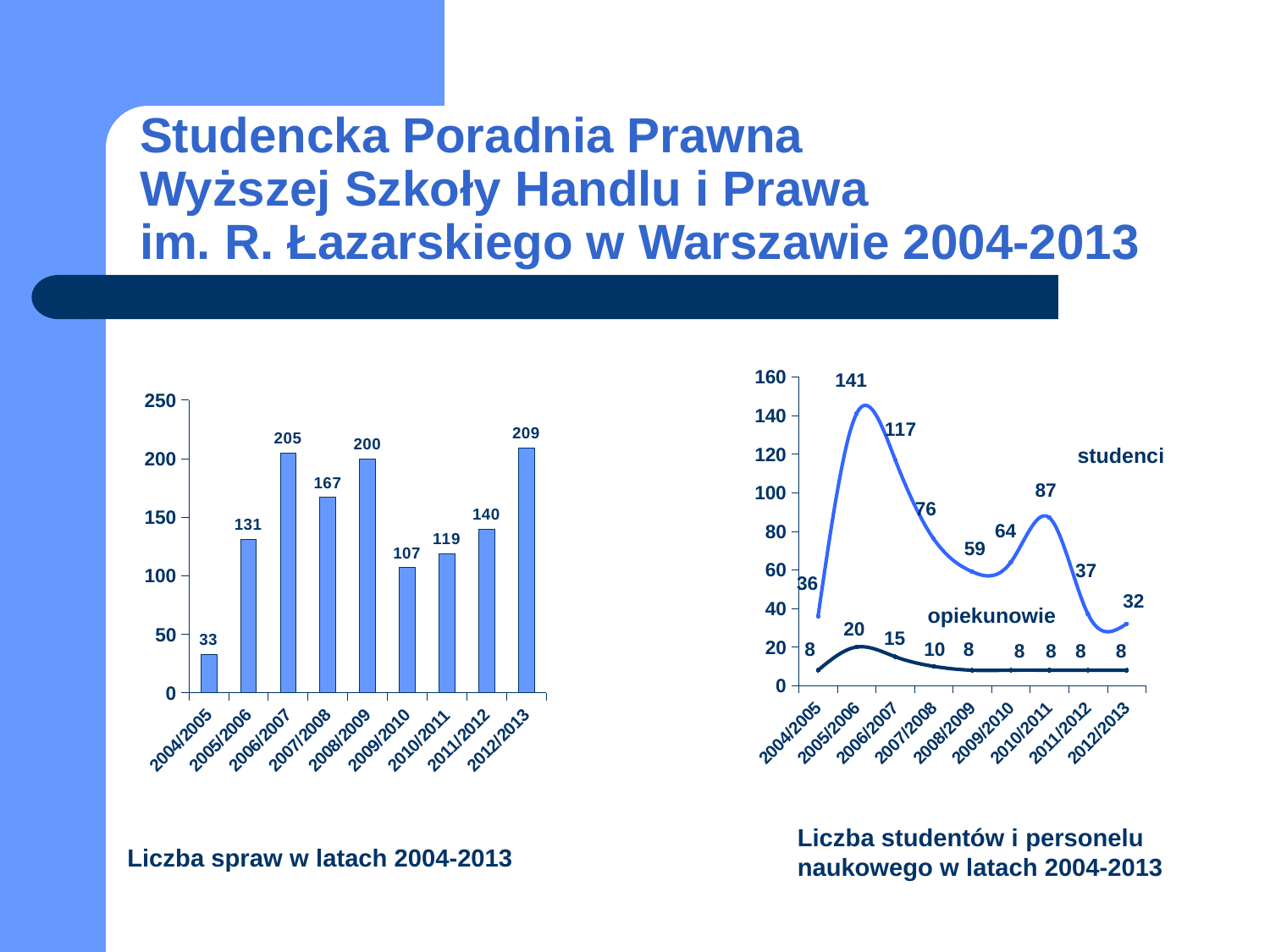
In the left chart (Liczba spraw w latach 2004-2013), which year has the lowest value? 2004/2005 In the left chart (Liczba spraw w latach 2004-2013), which year has the highest value? 2012/2013 What kind of chart is the left chart (Liczba spraw w latach 2004-2013)? bar chart In the right chart (Liczba studentów i personelu naukowego), how many series are plotted? 2 In the left chart (Liczba spraw w latach 2004-2013), what is the difference between the values for 2012/2013 and 2009/2010? 102 In the right chart (Liczba studentów i personelu naukowego), what is the value for studenci in 2005/2006? 141 In the right chart (Liczba studentów i personelu naukowego), what is the value for opiekunowie in 2006/2007? 15 In the left chart (Liczba spraw w latach 2004-2013), what is the value for 2006/2007? 205 In the right chart (Liczba studentów i personelu naukowego), what is the difference between studenci and opiekunowie in 2012/2013? 24 In the right chart (Liczba studentów i personelu naukowego), which is larger: studenci in 2010/2011 or studenci in 2009/2010? studenci in 2010/2011 In the left chart (Liczba spraw w latach 2004-2013), how many years are shown on the x axis? 9 What kind of chart is the right chart (Liczba studentów i personelu naukowego)? line chart